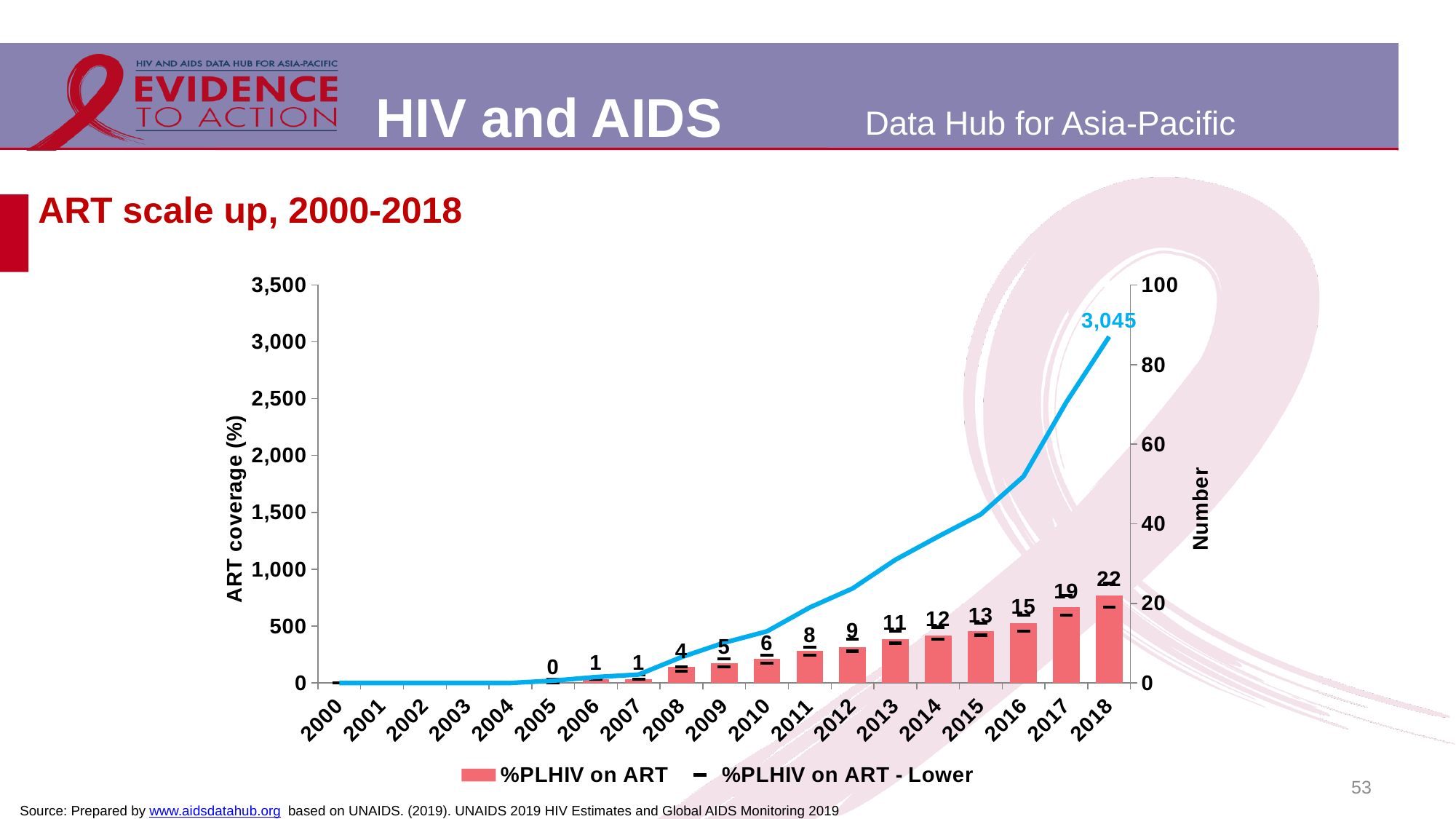
What is the %PLHIV on ART value for 2013? 11 What is the %PLHIV on ART value for 2018? 22 How many series does the legend list? 2 What value is labelled on the blue line at 2018? 3,045 What is the difference between the %PLHIV on ART values for 2016 and 2012? 6 Do the %PLHIV on ART bars rise or fall from 2005 to 2018? rise How many years are shown on the x axis? 19 What is the title of the chart? ART scale up, 2000-2018 Which is larger, the %PLHIV on ART value for 2014 or for 2010? 2014 What is the difference between the %PLHIV on ART values for 2018 and 2017? 3 Which year has the highest %PLHIV on ART value? 2018 What is the %PLHIV on ART value for 2008? 4